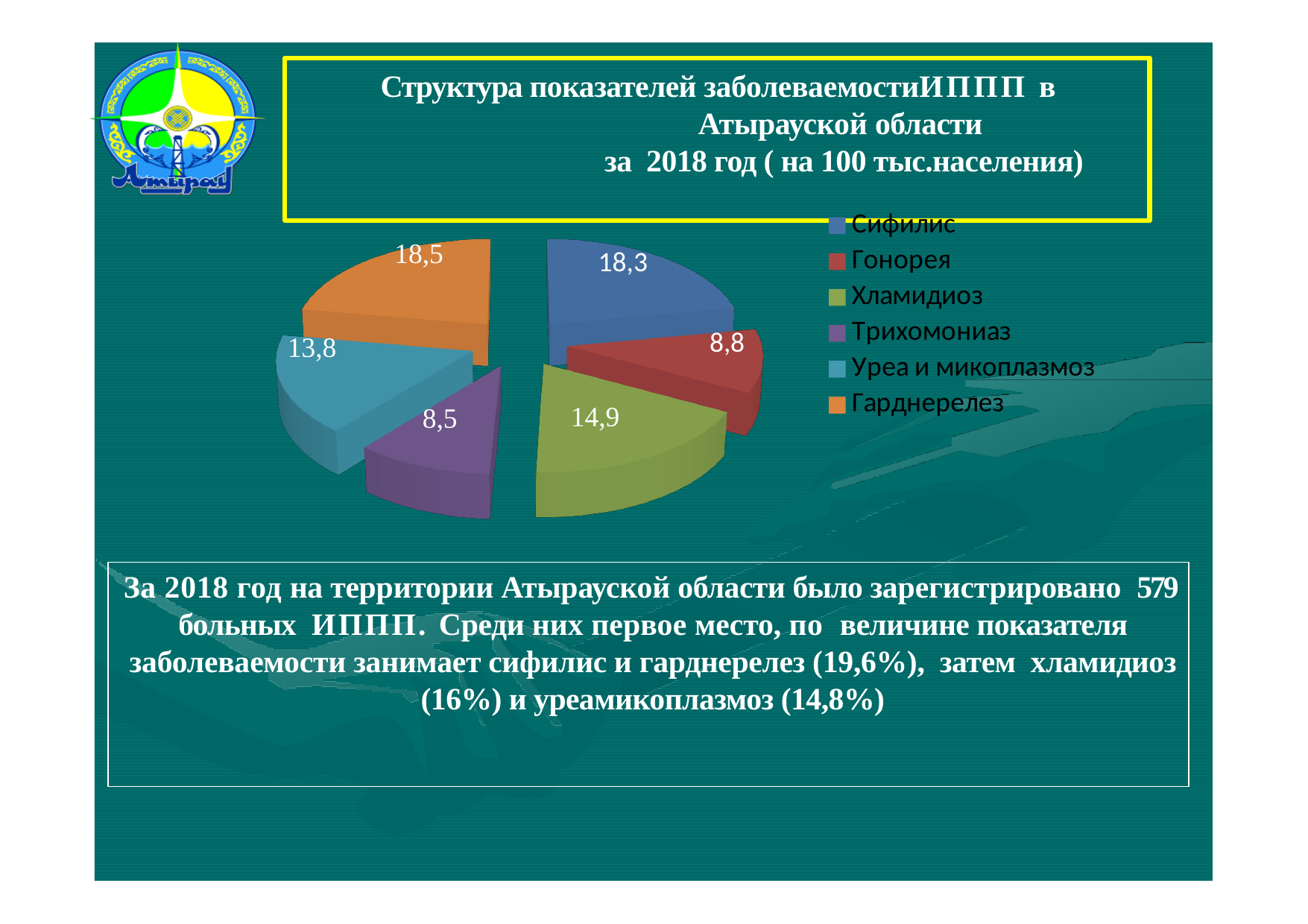
What is the difference between the values for Гарднерелез and Трихомониаз? 10 What is the value shown for Гонорея on the pie chart? 8,8 What is the value shown for Уреа и микоплазмоз on the pie chart? 13,8 What is the value shown for Хламидиоз on the pie chart? 14,9 What is the value shown for Гарднерелез on the pie chart? 18,5 What kind of chart is shown on the slide? Pie chart How many categories are shown on the pie chart? 6 What is the value shown for Сифилис on the pie chart? 18,3 Which is larger, the value for Хламидиоз or the value for Уреа и микоплазмоз? Хламидиоз Which category has the lowest value on the pie chart? Трихомониаз Which category has the highest value on the pie chart? Гарднерелез What is the difference between the values for Сифилис and Гонорея? 9,5